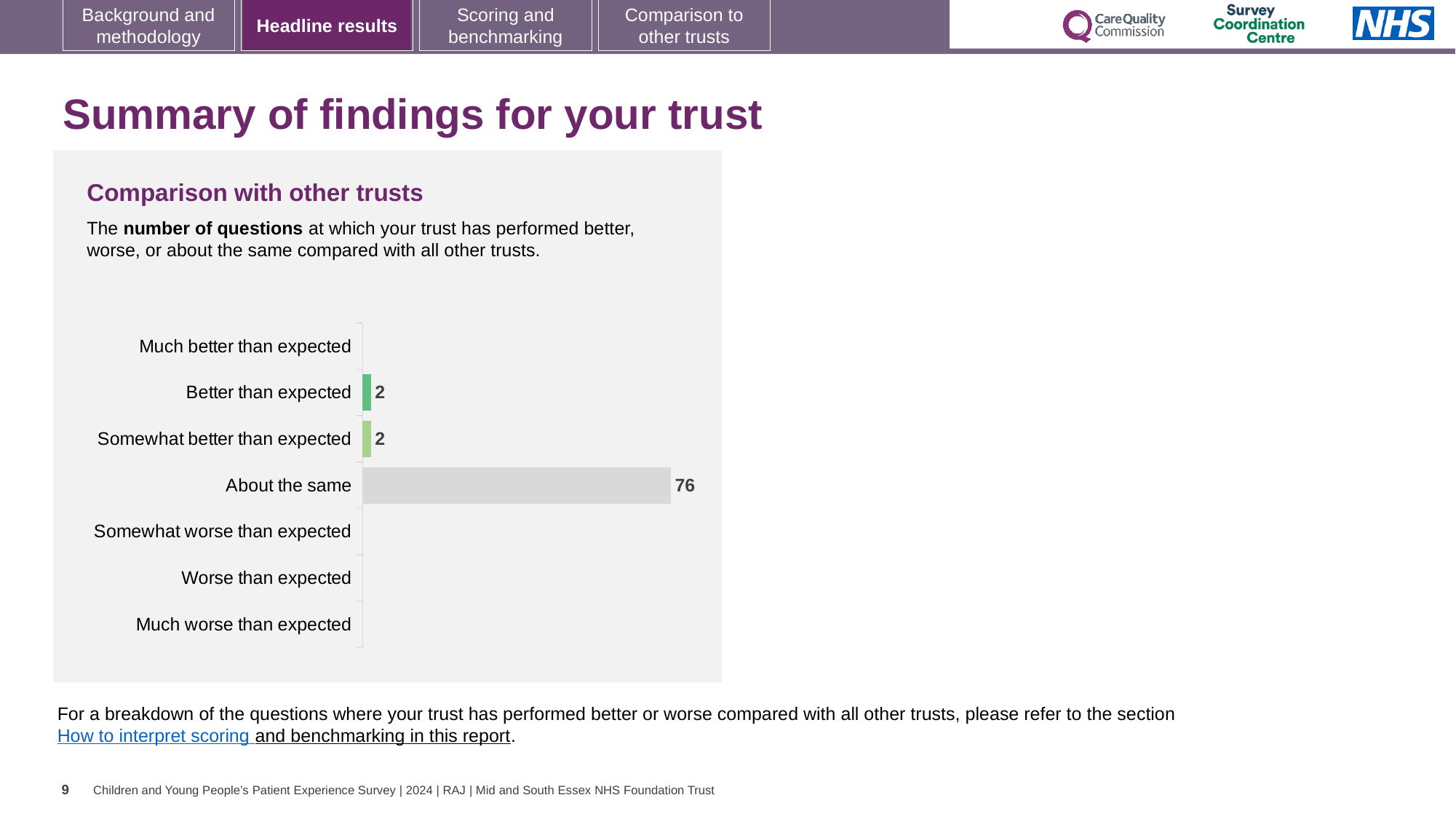
How many questions are in the 'Better than expected' category? 2 Which is larger: the number of questions 'About the same' or 'Somewhat better than expected'? About the same What is the total number of questions across the 'Better than expected' and 'Somewhat better than expected' categories? 4 How many questions are in the 'Somewhat better than expected' category? 2 What is the difference between the number of questions 'About the same' and 'Better than expected'? 74 What kind of chart is shown on the slide? Bar chart How many questions are in the 'About the same' category? 76 What is the title of the chart section on the slide? Comparison with other trusts How many categories are listed on the chart's axis? 7 Which category has the highest number of questions? About the same What colour is the bar for 'About the same'? Grey